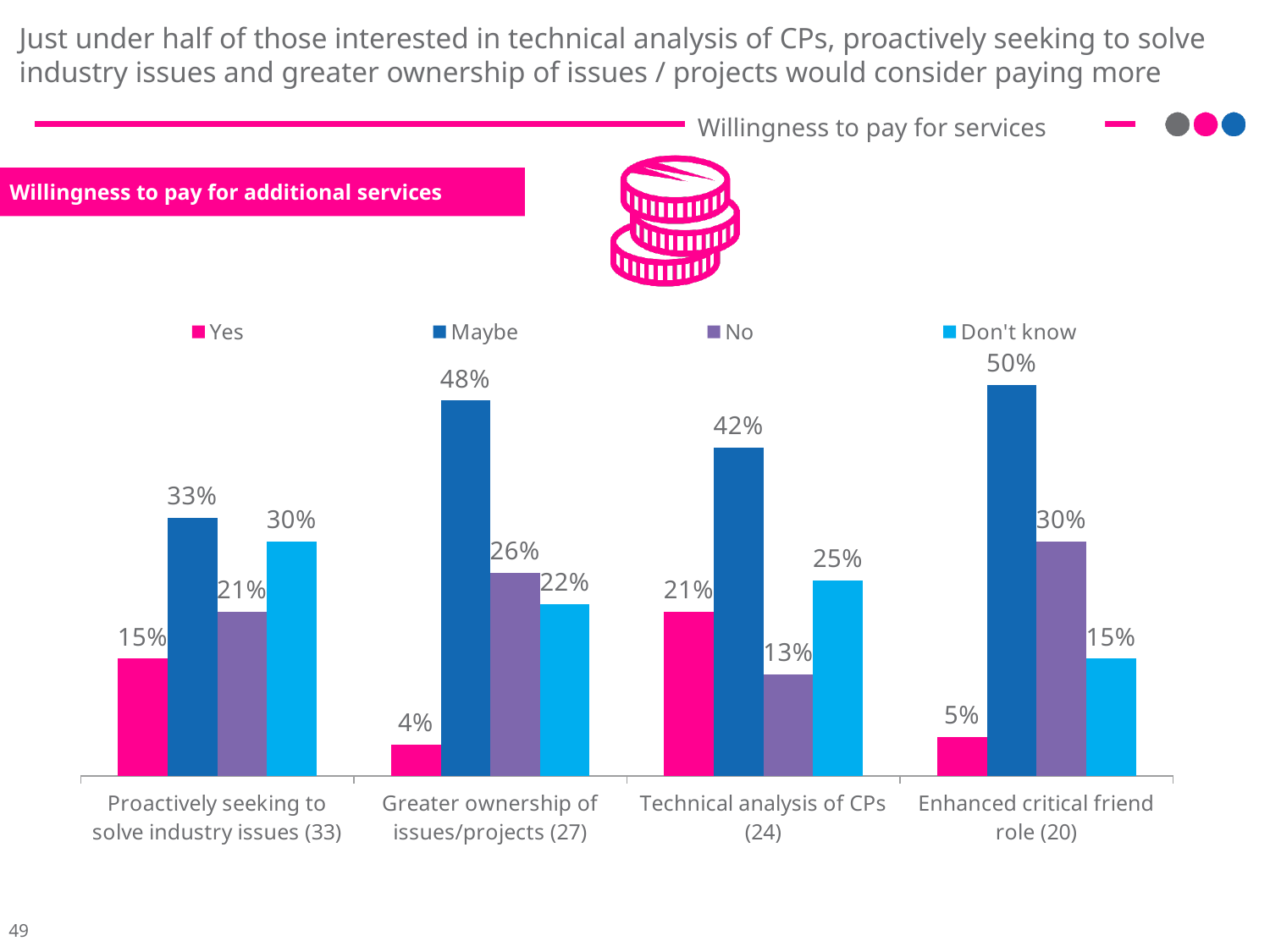
What colour represents the 'Yes' series in the legend? Pink What percentage answered 'Don't know' for Proactively seeking to solve industry issues (33)? 30% What is the difference between the 'Maybe' values for Enhanced critical friend role (20) and Proactively seeking to solve industry issues (33)? 17% What percentage answered 'Maybe' for Enhanced critical friend role (20)? 50% How many series does the legend list? 4 What percentage answered 'No' for Greater ownership of issues/projects (27)? 26% Which is larger: the 'No' value for Enhanced critical friend role (20) or the 'No' value for Technical analysis of CPs (24)? Enhanced critical friend role (20) What kind of chart is shown on the slide? Bar chart Which category has the highest 'Yes' value? Technical analysis of CPs (24) How many categories are shown on the x axis? 4 What percentage answered 'Yes' for Technical analysis of CPs (24)? 21% Which category has the lowest 'Yes' value? Greater ownership of issues/projects (27)